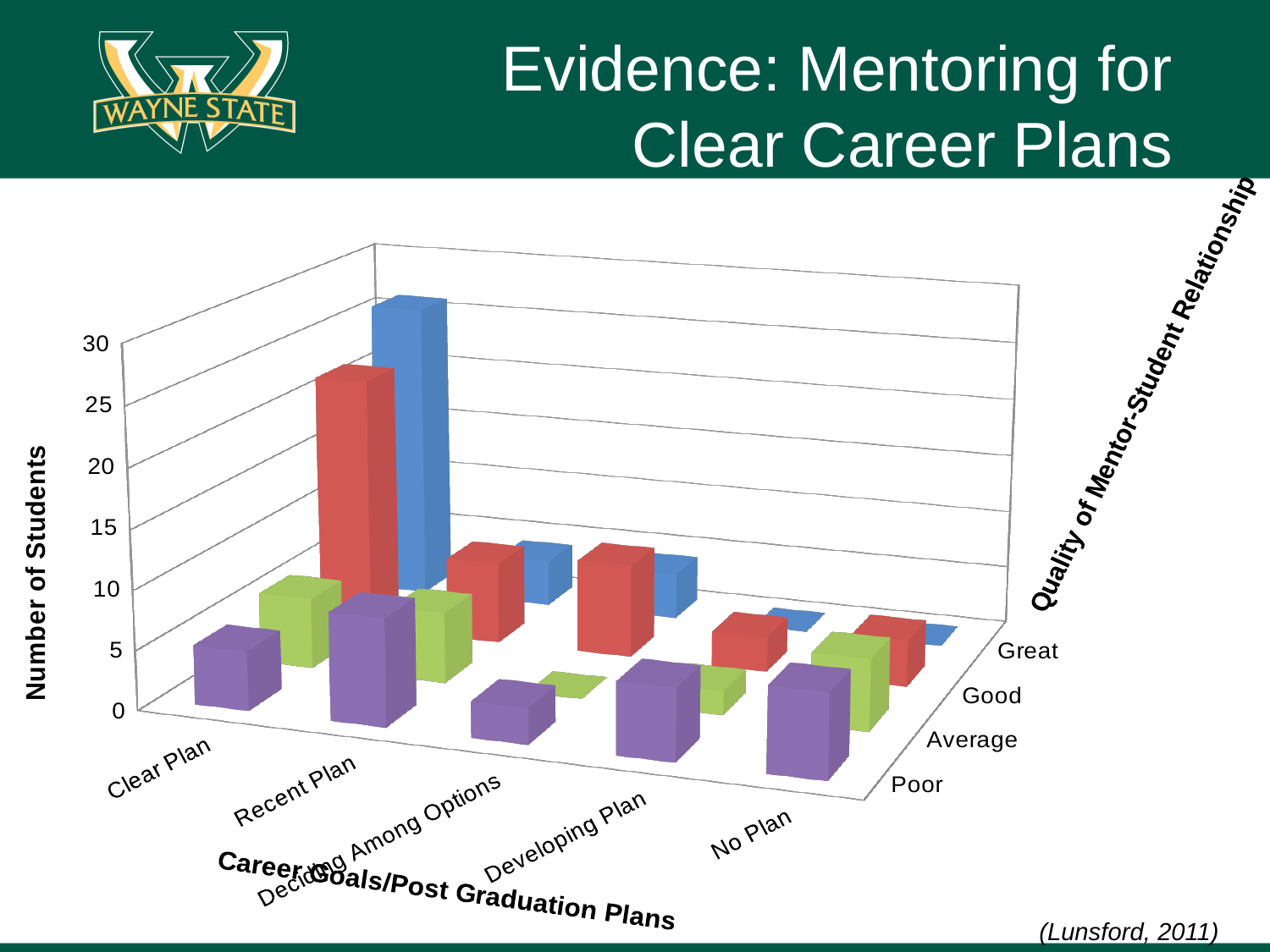
Is the value for No Plan with a Poor mentor-student relationship greater or less than 15? less Is the value for Clear Plan with a Poor mentor-student relationship greater or less than 10? less Is the value for Recent Plan with a Great mentor-student relationship greater or less than 20? less For a Good mentor-student relationship, which is larger: the value for Recent Plan or the value for Developing Plan? Recent Plan What is the title of the vertical axis? Number of Students What kind of chart is shown on the slide? bar chart How many career goal categories are shown along the x axis? 5 What is the title of the depth axis on the right side of the chart? Quality of Mentor-Student Relationship How many quality levels of mentor-student relationship are shown on the depth axis? 4 Which career plan category has the tallest bar in the chart? Clear Plan Which quality of mentor-student relationship has the tallest bar in the chart? Great